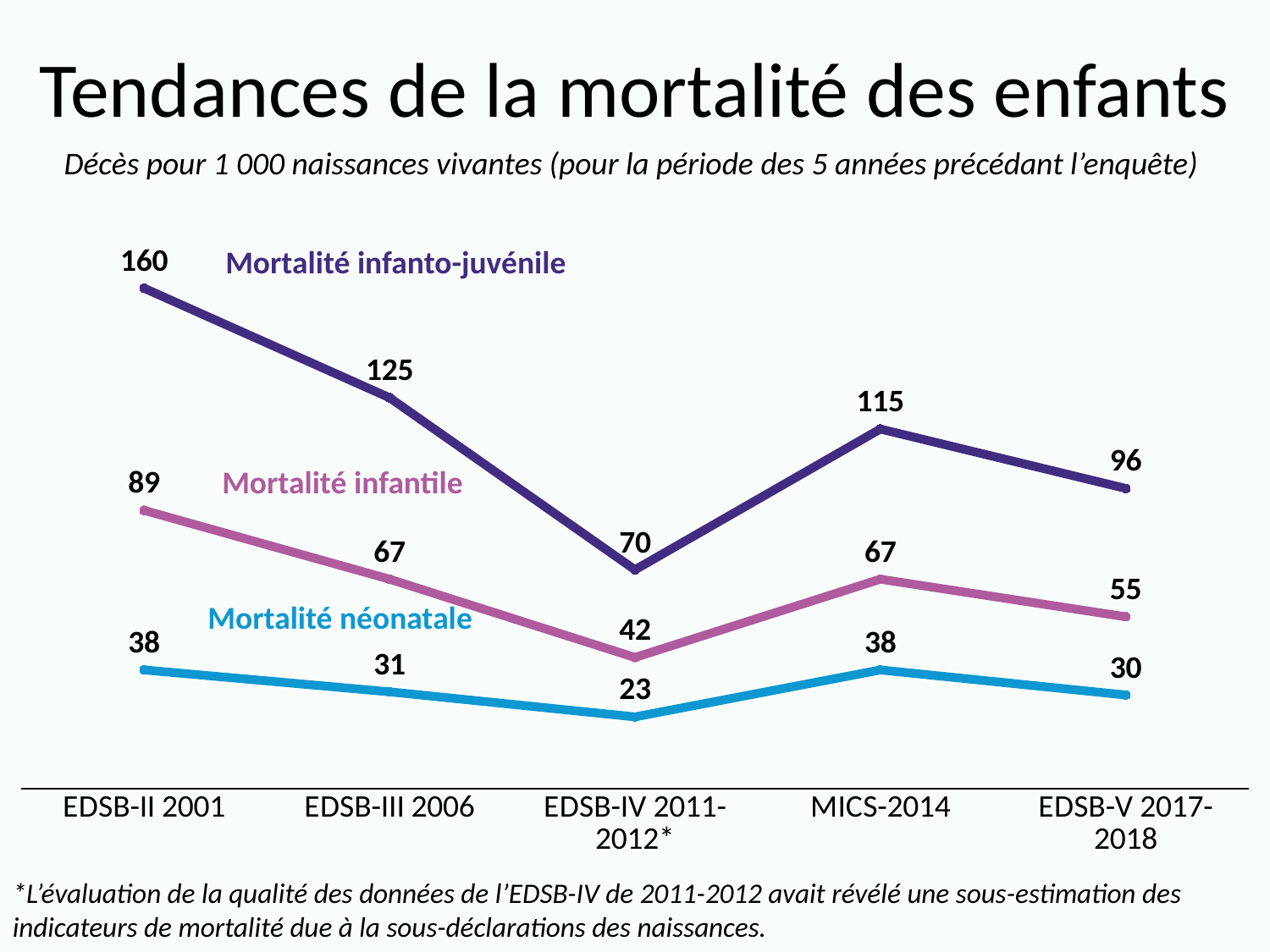
What is the difference between Mortalité infantile and Mortalité néonatale for EDSB-V 2017-2018? 25 Which survey has the lowest value for Mortalité infantile? EDSB-IV 2011-2012* What is the value of Mortalité néonatale for EDSB-IV 2011-2012*? 23 What is the difference between Mortalité infanto-juvénile for EDSB-II 2001 and EDSB-III 2006? 35 What is the value of Mortalité infanto-juvénile for EDSB-V 2017-2018? 96 How many series are plotted on the chart? 3 Which survey has the highest value for Mortalité infanto-juvénile? EDSB-II 2001 What is the value of Mortalité infantile for MICS-2014? 67 Which is larger: Mortalité infanto-juvénile for MICS-2014 or for EDSB-V 2017-2018? MICS-2014 How many surveys are shown on the x axis? 5 What kind of chart is shown on the slide? Line chart What is the value of Mortalité infanto-juvénile for EDSB-II 2001? 160